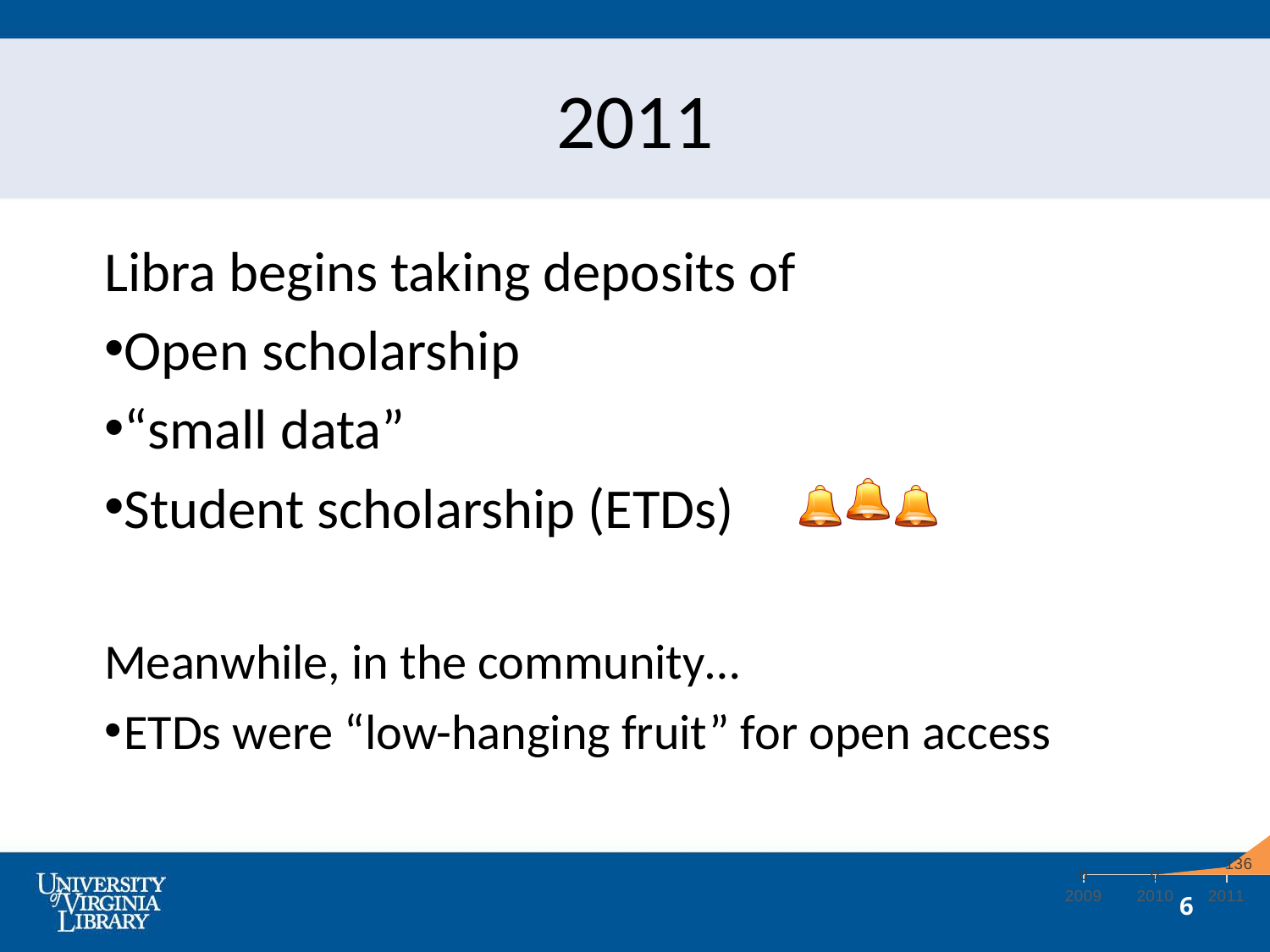
What kind of chart is shown in the bottom-right corner of the slide? area chart In the small chart at the bottom right, is the value for 2011 larger or smaller than the value for 2010? larger What are the x-axis labels on the small chart at the bottom right? 2009, 2010, 2011 In the small chart at the bottom right, what value is labelled for 2011? 136 In the small chart at the bottom right, do the values rise or fall from 2009 to 2011? rise How many years are labelled on the x axis of the small chart at the bottom right? 3 What colour is the plotted area in the small chart at the bottom right? orange In the small chart at the bottom right, which year has the highest value? 2011